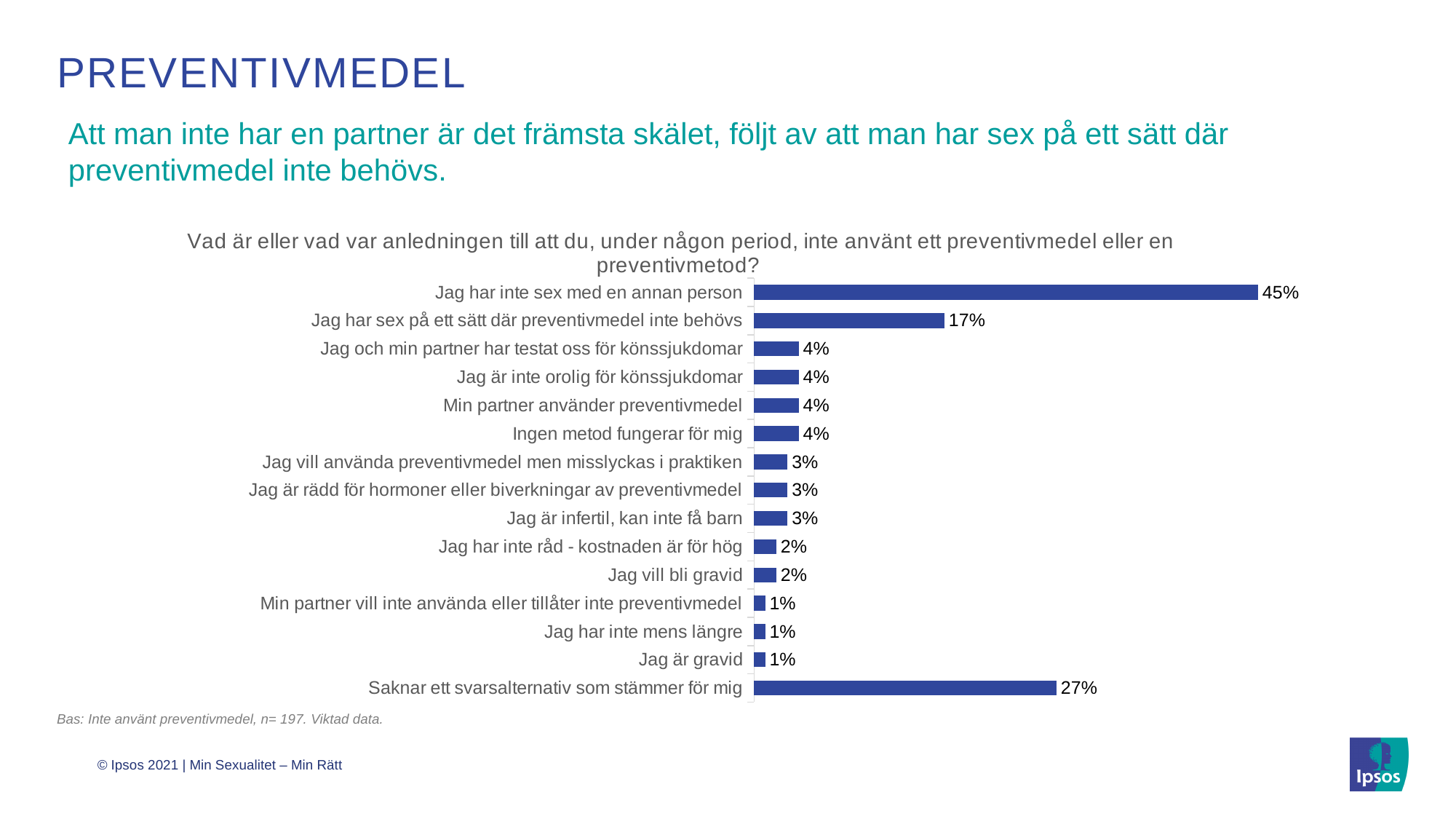
Which category has the highest value? Jag har inte sex med en annan person What is the value for "Saknar ett svarsalternativ som stämmer för mig"? 27% What is the difference between "Jag har inte sex med en annan person" and "Saknar ett svarsalternativ som stämmer för mig"? 18 percentage points Which is larger, "Saknar ett svarsalternativ som stämmer för mig" or "Jag har sex på ett sätt där preventivmedel inte behövs"? Saknar ett svarsalternativ som stämmer för mig What is the value for "Jag har sex på ett sätt där preventivmedel inte behövs"? 17% How many categories are shown in the chart? 15 What kind of chart is shown on the slide? Bar chart What is the base (n) stated below the chart? n= 197 What is the value for "Jag vill bli gravid"? 2% What is the value for "Jag är infertil, kan inte få barn"? 3% What is the value for "Jag har inte sex med en annan person"? 45% What is the difference between "Jag har sex på ett sätt där preventivmedel inte behövs" and "Jag och min partner har testat oss för könssjukdomar"? 13 percentage points